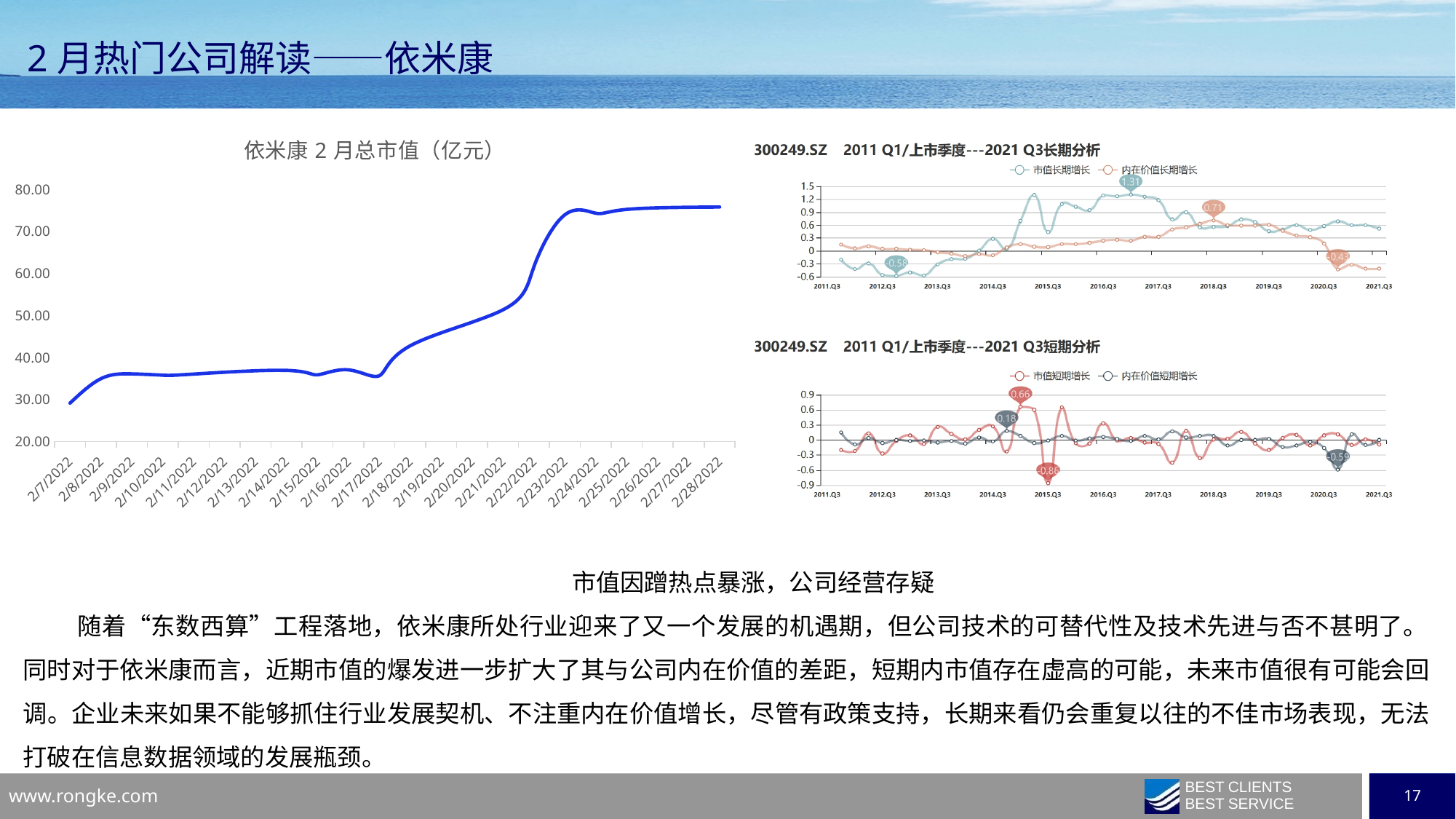
In the bottom-right chart 300249.SZ 2011 Q1/上市季度---2021 Q3短期分析, what is the lowest labelled value of the 市值短期增长 series? -0.86 In the top-right chart 300249.SZ 2011 Q1/上市季度---2021 Q3长期分析, what is the highest labelled value of the 市值长期增长 series? 1.31 In the left chart 依米康 2 月总市值（亿元）, is the value for 2/28/2022 greater or less than 70.00? greater In the top-right chart 300249.SZ 2011 Q1/上市季度---2021 Q3长期分析, what is the labelled peak value of the 内在价值长期增长 series near 2018.Q3? 0.71 In the left chart 依米康 2 月总市值（亿元）, which date has the lowest value? 2/7/2022 In the bottom-right chart 300249.SZ 2011 Q1/上市季度---2021 Q3短期分析, what are the two series listed in the legend? 市值短期增长 and 内在价值短期增长 In the left chart 依米康 2 月总市值（亿元）, do the values generally rise or fall from 2/7/2022 to 2/28/2022? rise In the left chart 依米康 2 月总市值（亿元）, is the value for 2/22/2022 greater or less than 50.00? greater In the left chart 依米康 2 月总市值（亿元）, how many dates are shown on the x axis? 22 In the left chart 依米康 2 月总市值（亿元）, is the value for 2/14/2022 greater or less than 40.00? less In the top-right chart 300249.SZ 2011 Q1/上市季度---2021 Q3长期分析, how many series does the legend list? 2 What kind of chart is the left chart titled 依米康 2 月总市值（亿元）? line chart